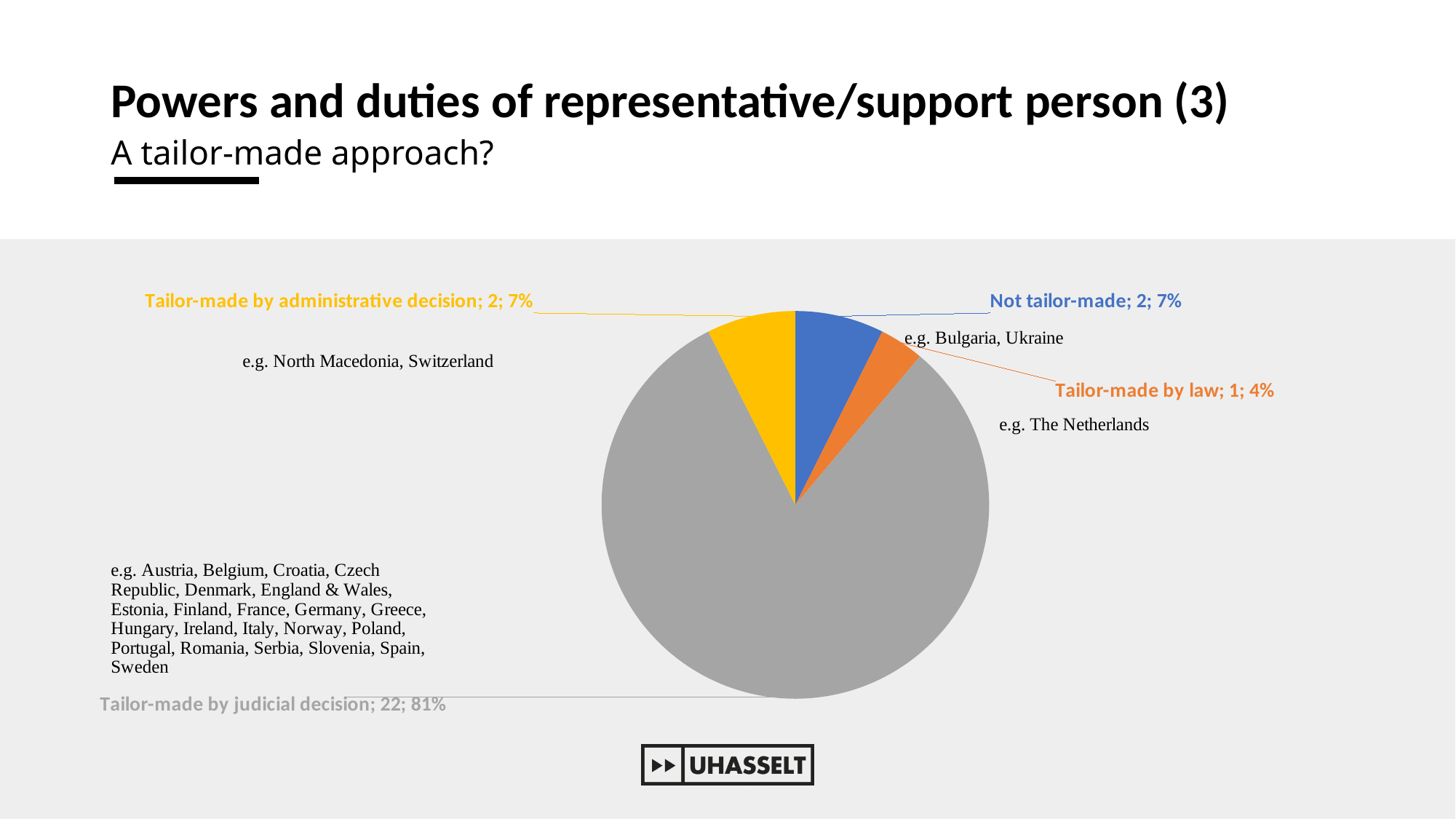
What is the count for 'Tailor-made by law'? 1 What percentage share does 'Not tailor-made' have? 7% What kind of chart is shown on the slide? pie chart Which category has the smallest slice? Tailor-made by law Which has a larger count, 'Not tailor-made' or 'Tailor-made by law'? Not tailor-made What is the total count across all slices of the pie chart? 27 What is the difference in count between 'Tailor-made by judicial decision' and 'Tailor-made by administrative decision'? 20 What colour is the 'Tailor-made by administrative decision' slice? yellow What percentage share does 'Tailor-made by judicial decision' have? 81% Which category has the largest slice? Tailor-made by judicial decision How many slices does the pie chart have? 4 What is the count for 'Tailor-made by judicial decision'? 22